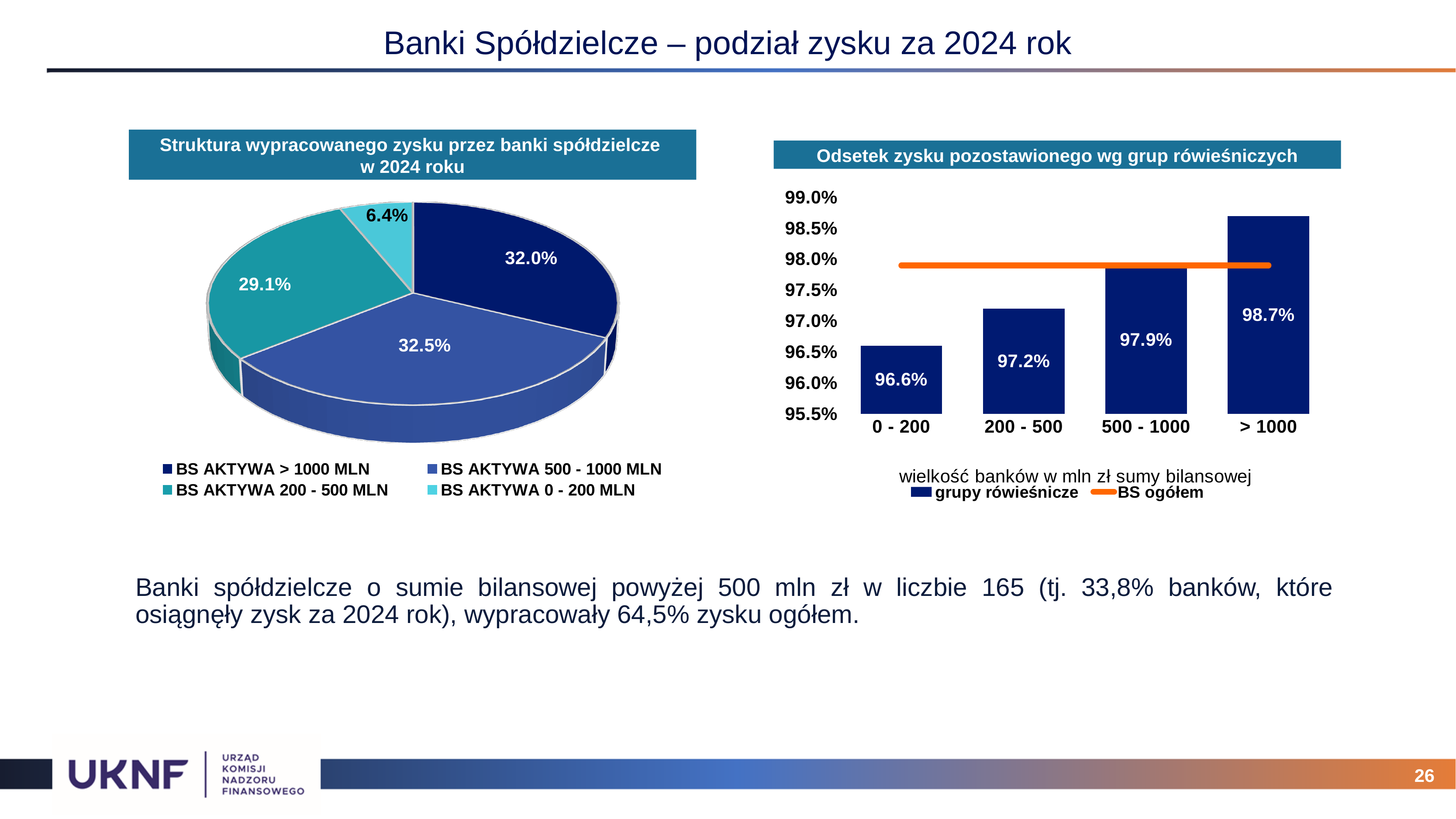
In the bar chart 'Odsetek zysku pozostawionego wg grup rówieśniczych', do the values rise or fall from left to right along the x axis? rise In the pie chart 'Struktura wypracowanego zysku przez banki spółdzielcze w 2024 roku', what share is shown for BS AKTYWA 0 - 200 MLN? 6.4% In the bar chart 'Odsetek zysku pozostawionego wg grup rówieśniczych', what is the value for the > 1000 group? 98.7% In the pie chart 'Struktura wypracowanego zysku przez banki spółdzielcze w 2024 roku', what share is shown for BS AKTYWA 200 - 500 MLN? 29.1% In the bar chart 'Odsetek zysku pozostawionego wg grup rówieśniczych', what is the difference between the values for > 1000 and 0 - 200? 2.1 percentage points In the bar chart 'Odsetek zysku pozostawionego wg grup rówieśniczych', how many series does the legend list? 2 In the pie chart 'Struktura wypracowanego zysku przez banki spółdzielcze w 2024 roku', which category has the smallest slice? BS AKTYWA 0 - 200 MLN In the bar chart 'Odsetek zysku pozostawionego wg grup rówieśniczych', what is the value for the 200 - 500 group? 97.2% In the pie chart 'Struktura wypracowanego zysku przez banki spółdzielcze w 2024 roku', which category has the largest slice? BS AKTYWA 500 - 1000 MLN In the pie chart 'Struktura wypracowanego zysku przez banki spółdzielcze w 2024 roku', what is the difference between the shares of BS AKTYWA > 1000 MLN and BS AKTYWA 200 - 500 MLN? 2.9 percentage points In the pie chart 'Struktura wypracowanego zysku przez banki spółdzielcze w 2024 roku', how many slices are there? 4 In the bar chart 'Odsetek zysku pozostawionego wg grup rówieśniczych', which group has the lowest value? 0 - 200